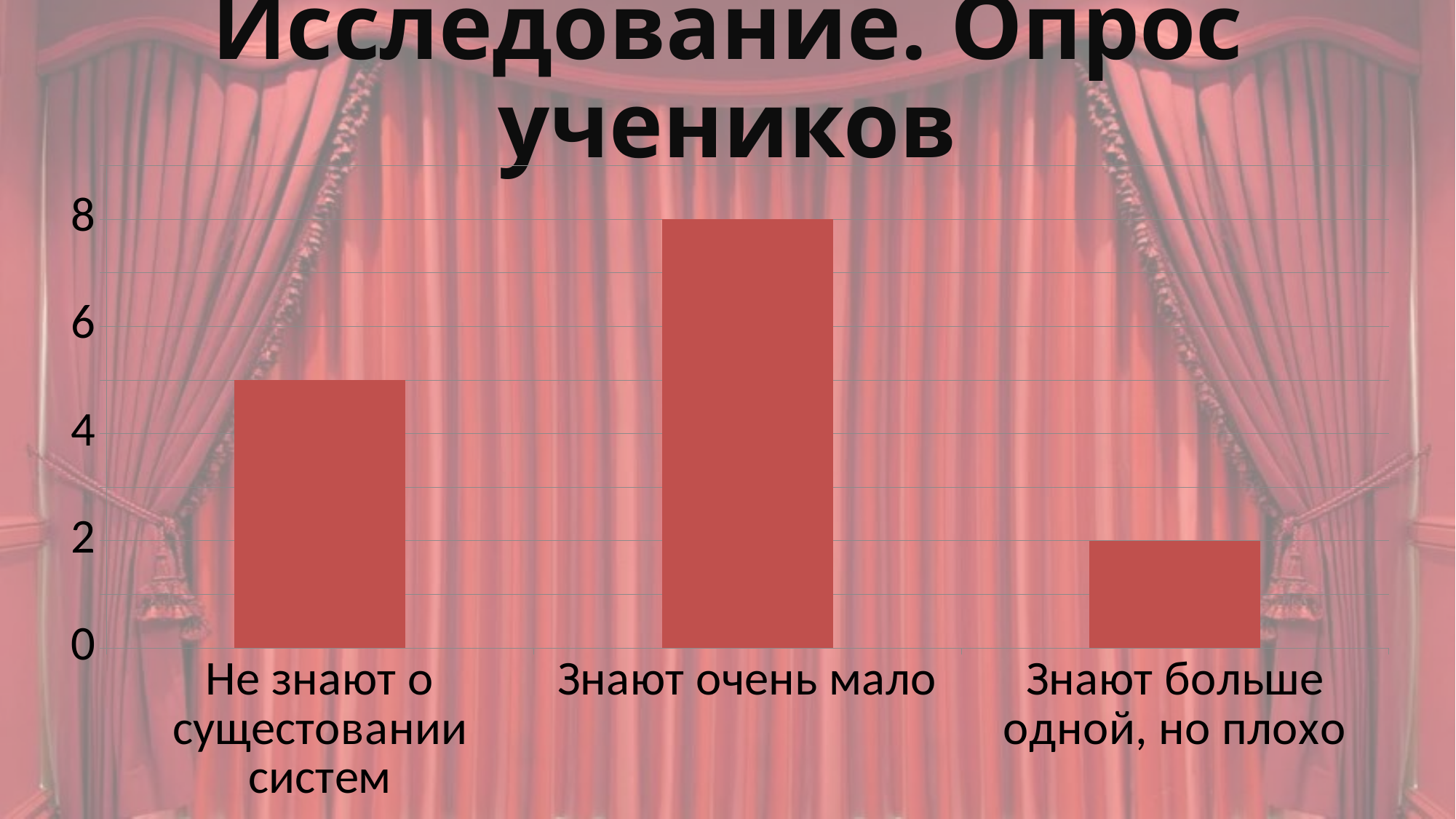
What is the title of the slide? Исследование. Опрос учеников Which is larger: the value for "Не знают о сущестовании систем" or the value for "Знают больше одной, но плохо"? Не знают о сущестовании систем What kind of chart is shown on the slide? bar chart Which category has the lowest bar? Знают больше одной, но плохо What value does the bar for "Знают очень мало" reach? 8 What is the difference between the values for "Знают очень мало" and "Знают больше одной, но плохо"? 6 Which category has the highest bar? Знают очень мало Is the value for "Не знают о сущестовании систем" greater or less than 4? greater What is the highest value labelled on the vertical axis? 8 Is the value for "Не знают о сущестовании систем" greater or less than 6? less How many categories are shown on the chart? 3 What value does the bar for "Знают больше одной, но плохо" reach? 2